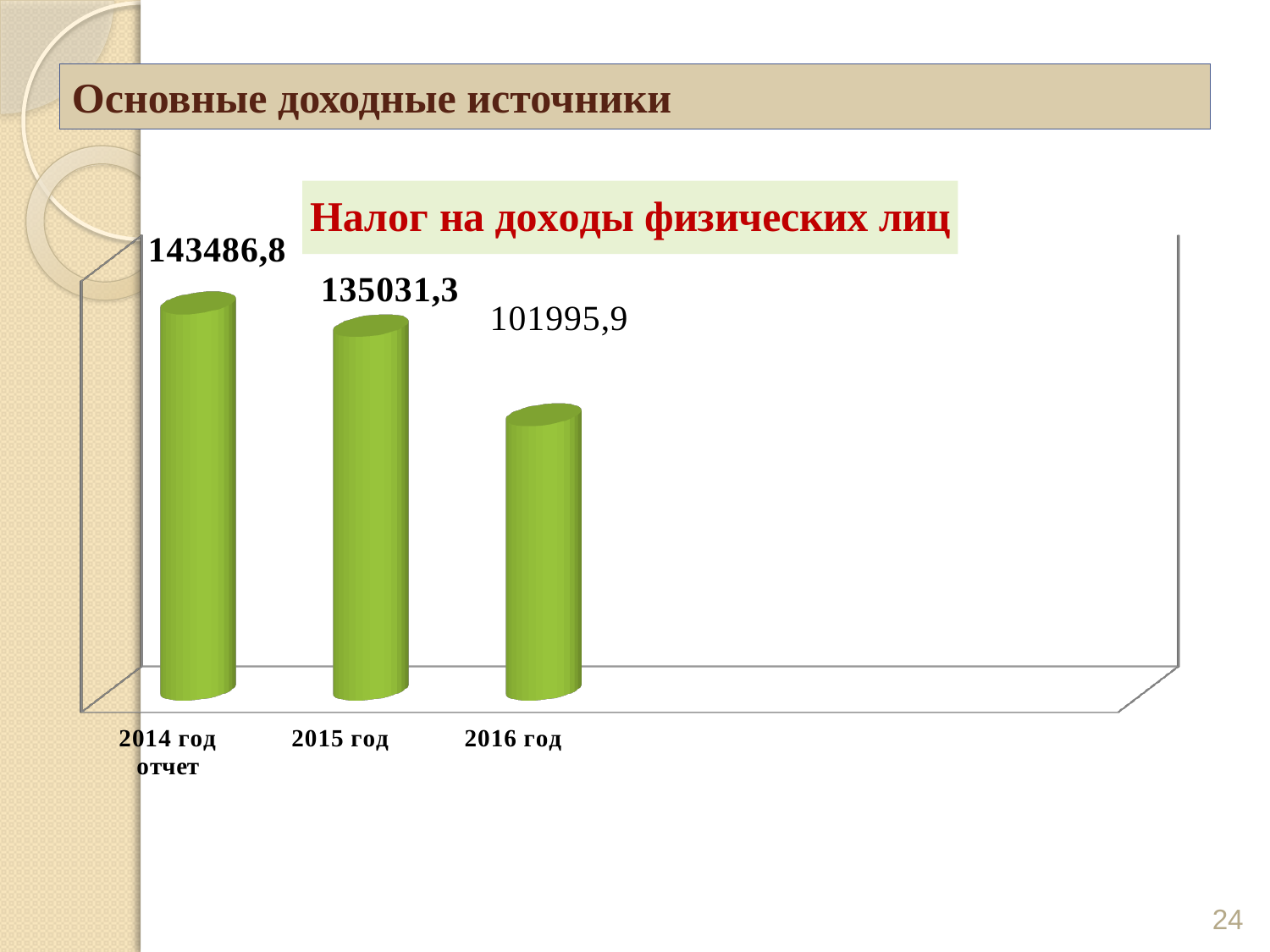
What kind of chart is shown on the slide? bar chart Do the values rise or fall from 2014 to 2016? fall Which year has the lowest value? 2016 год What is the value for 2015 год? 135031,3 Which is larger, the value for 2015 год or the value for 2016 год? 2015 год Which year has the highest value? 2014 год отчет How many bars are shown in the chart? 3 What is the value for 2016 год? 101995,9 What is the difference between the values for 2015 год and 2016 год? 33035,4 What is the difference between the values for 2014 год отчет and 2016 год? 41490,9 What is the value for 2014 год отчет? 143486,8 What is the difference between the values for 2014 год отчет and 2015 год? 8455,5